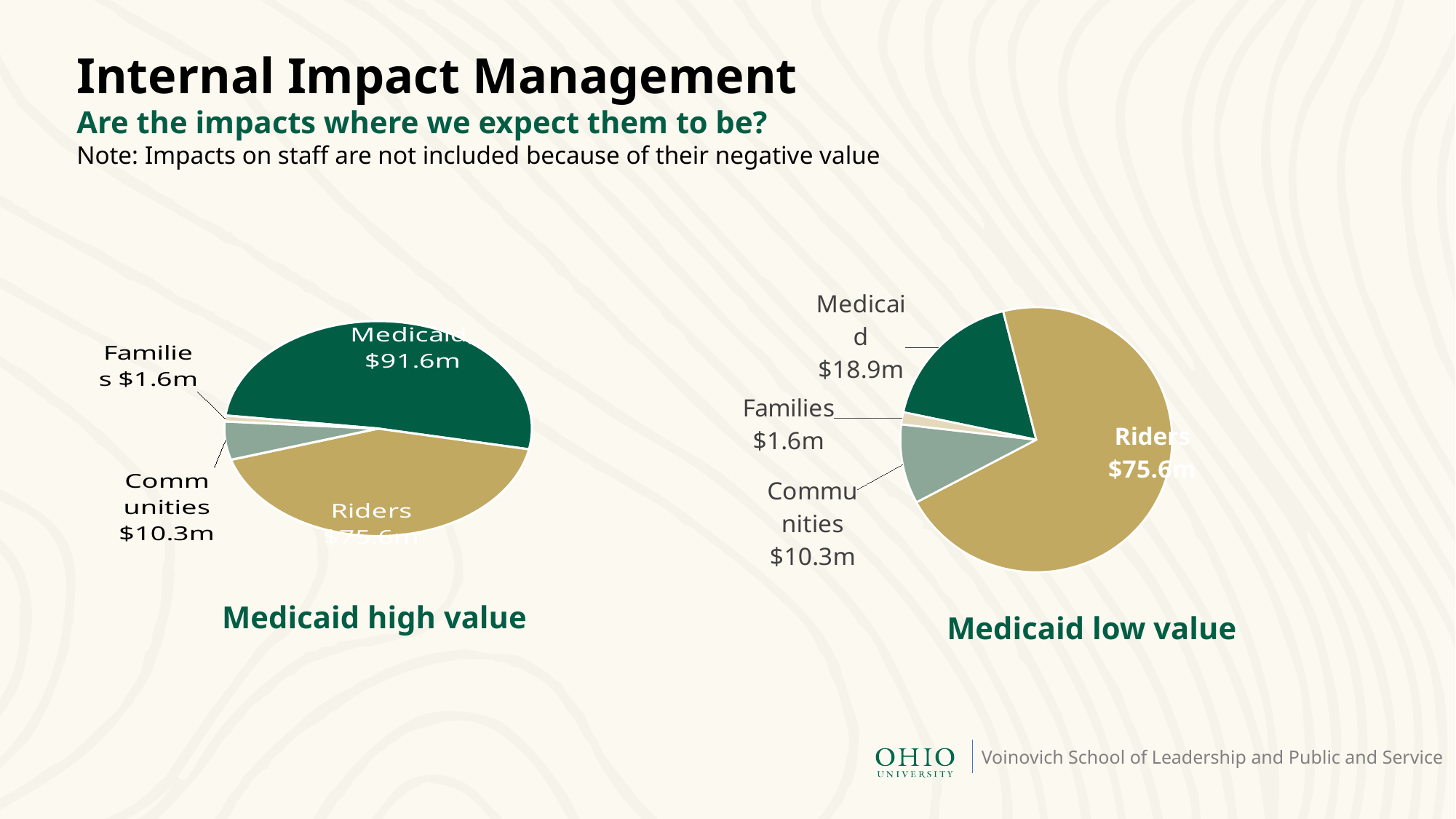
In the "Medicaid high value" chart, what is the value for Communities? $10.3m In the "Medicaid low value" chart, what is the value for Riders? $75.6m How many slices does the "Medicaid low value" pie chart have? 4 In the "Medicaid high value" chart, what is the difference between the Medicaid and Riders values? $16.0m In the "Medicaid low value" chart, what is the value for Families? $1.6m In the "Medicaid low value" chart, which is larger, Riders or Medicaid? Riders In the "Medicaid low value" chart, which category has the smallest slice? Families In the "Medicaid high value" chart, what is the value for Medicaid? $91.6m In the "Medicaid low value" chart, what is the difference between the Riders and Medicaid values? $56.7m In the "Medicaid high value" chart, which category has the largest slice? Medicaid In the "Medicaid low value" chart, what is the value for Medicaid? $18.9m What kind of chart is the "Medicaid high value" chart? Pie chart